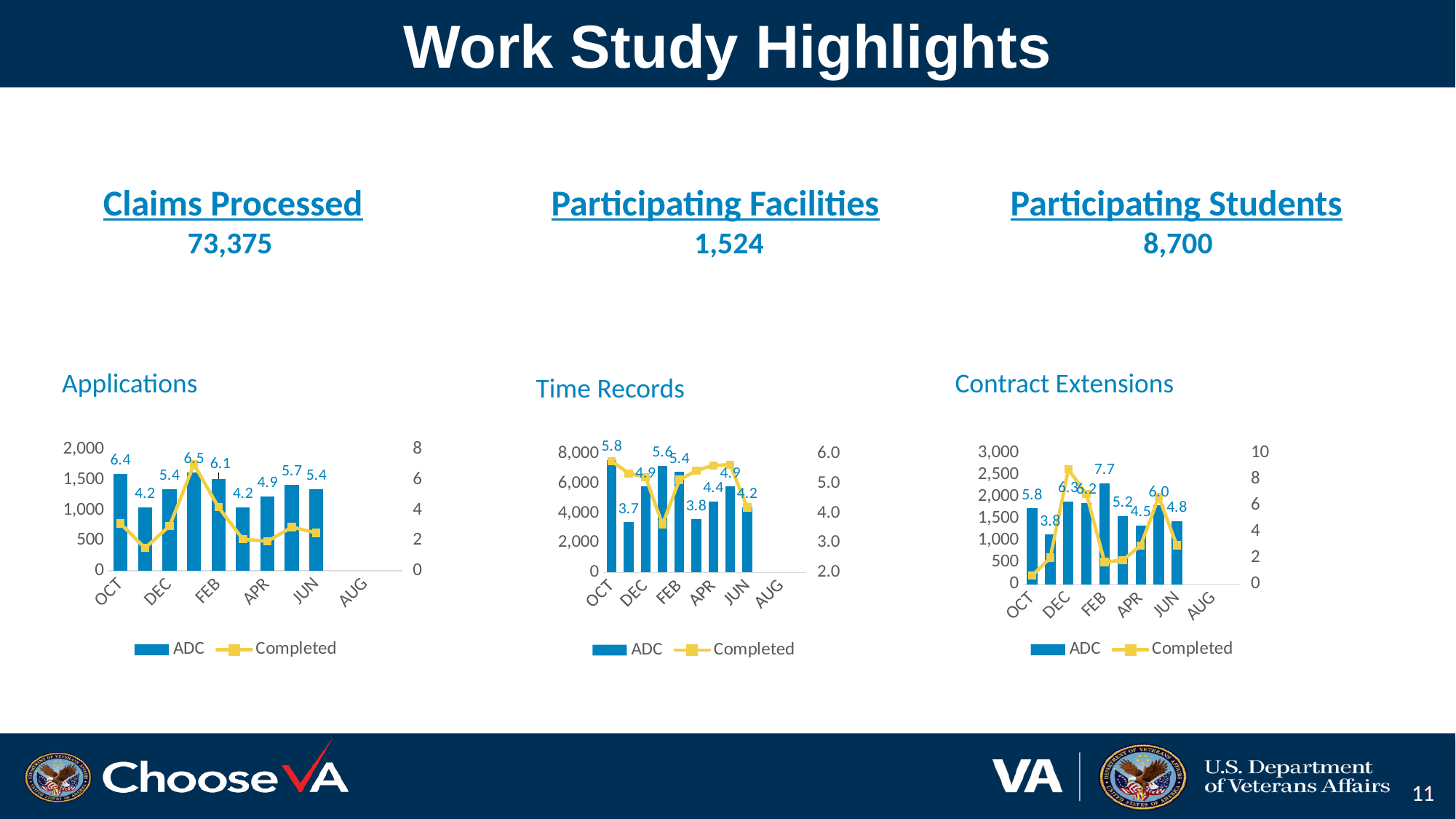
In the Time Records chart, what is the lowest ADC data label shown? 3.7 In the Applications chart, what is the difference between the ADC labels for OCT and FEB? 0.3 In the Applications chart, what is the highest ADC data label shown? 6.5 In the Time Records chart, what is the ADC value labelled for OCT? 5.8 What are the two legend entries in the Contract Extensions chart? ADC and Completed In the Contract Extensions chart, which labelled month has the highest ADC value? FEB In the Time Records chart, which has the larger ADC label, OCT or JUN? OCT How many bars are plotted in the Applications chart? 9 In the Contract Extensions chart, what is the difference between the ADC labels for FEB and JUN? 2.9 In the Contract Extensions chart, what is the ADC value labelled for FEB? 7.7 How many series does the legend of the Time Records chart list? 2 In the Applications chart, what is the ADC value labelled for OCT? 6.4